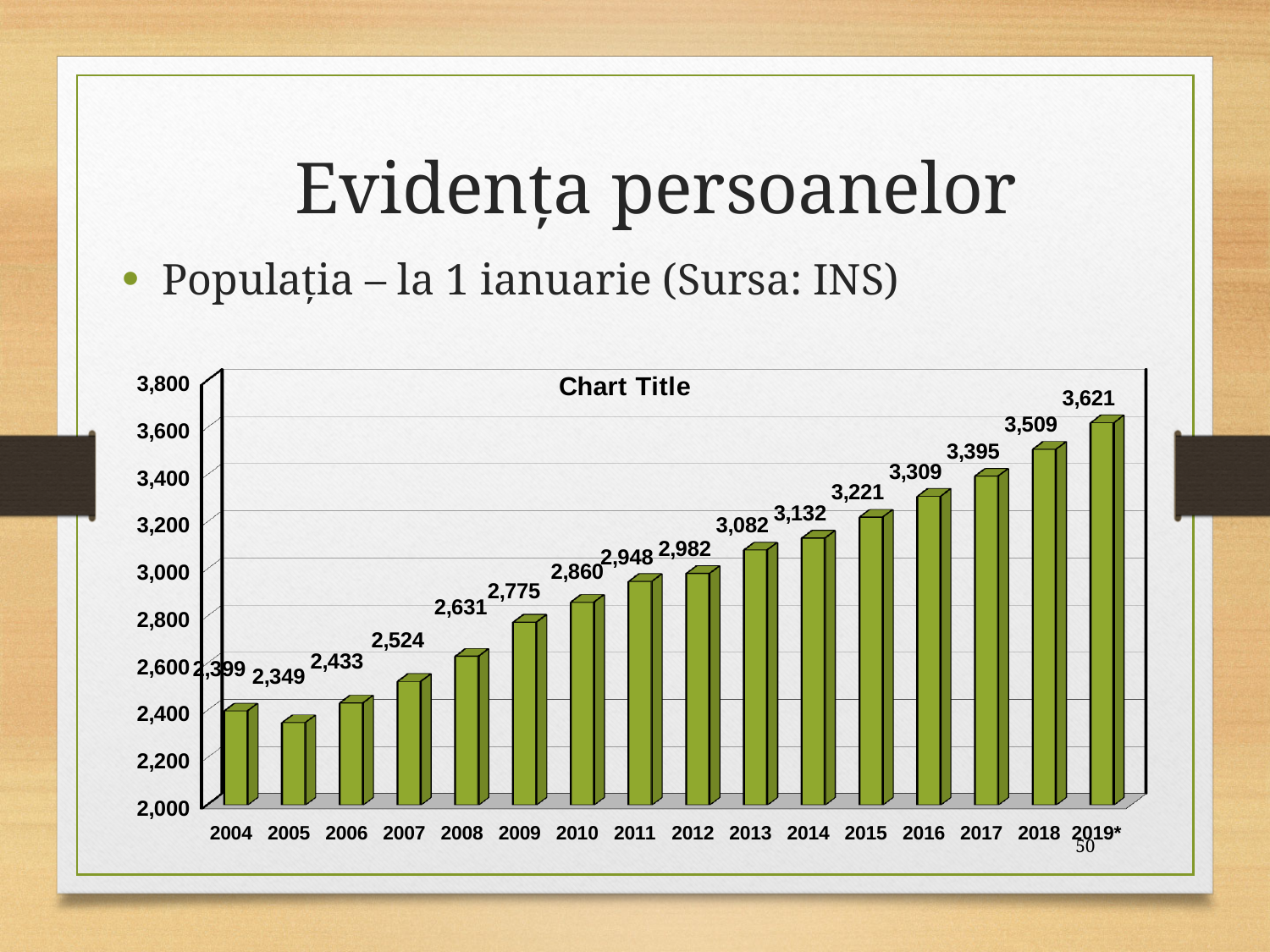
What kind of chart is shown on the slide? bar chart What is the value for 2004? 2,399 How many years are shown on the x axis? 16 What is the difference between the values for 2019* and 2018? 112 Is the value for 2014 greater or less than 3,000? greater What is the difference between the values for 2012 and 2011? 34 Which year has the lowest value? 2005 What is the value for 2016? 3,309 Which is larger, the value for 2007 or the value for 2009? 2009 What is the value for 2010? 2,860 Do the values generally rise or fall from 2005 to 2019*? rise Which year has the highest value? 2019*